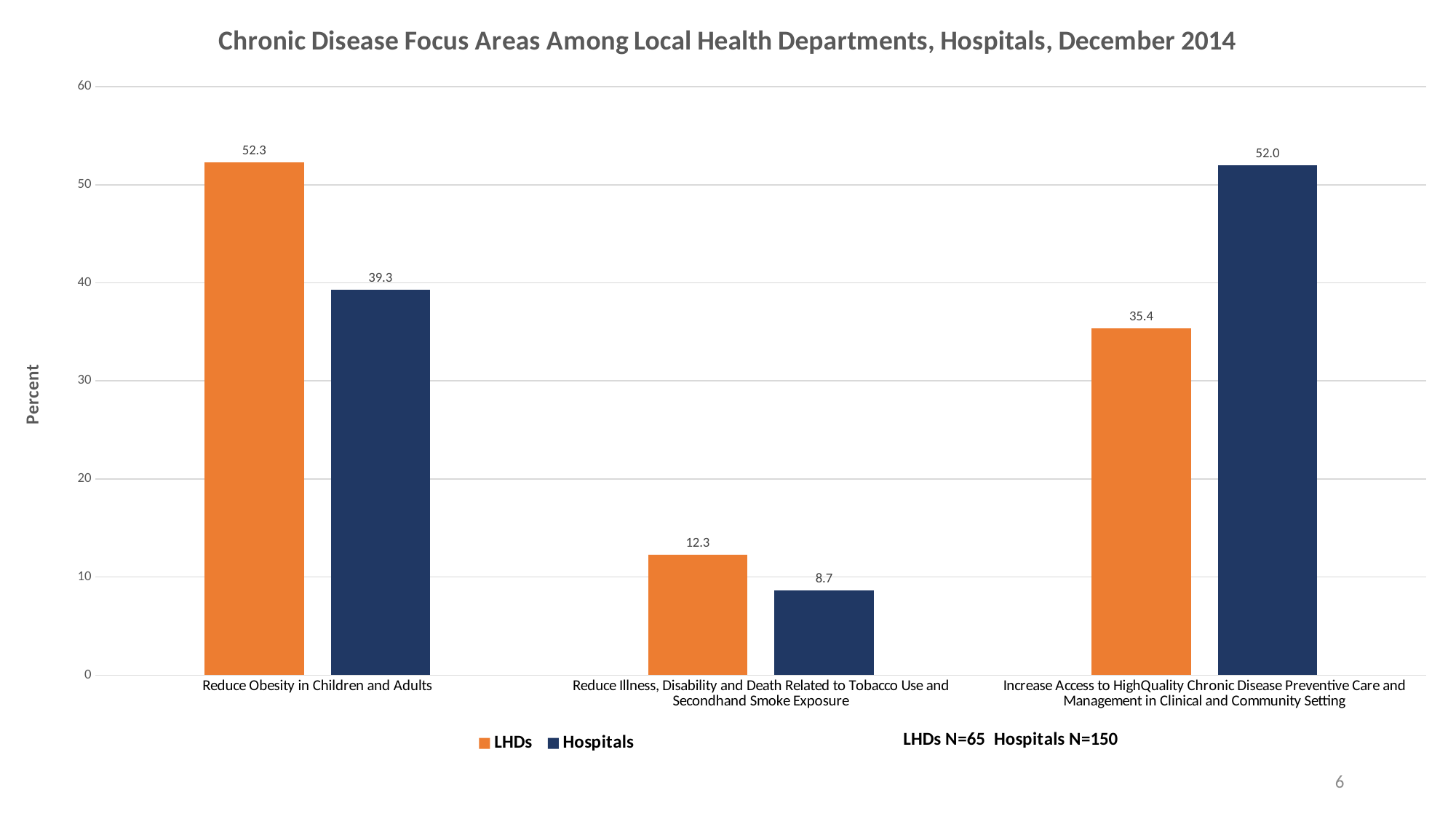
Which focus area has the lowest LHDs value? Reduce Illness, Disability and Death Related to Tobacco Use and Secondhand Smoke Exposure What kind of chart is shown on the slide? Bar chart What is the LHDs value for Reduce Obesity in Children and Adults? 52.3 Is the Hospitals value for Reduce Obesity in Children and Adults greater or less than 40? less For Increase Access to HighQuality Chronic Disease Preventive Care and Management in Clinical and Community Setting, which is larger: the LHDs value or the Hospitals value? Hospitals How many focus area categories are shown on the x axis? 3 What is the Hospitals value for Reduce Illness, Disability and Death Related to Tobacco Use and Secondhand Smoke Exposure? 8.7 What is the difference between the LHDs and Hospitals values for Reduce Obesity in Children and Adults? 13.0 What is the label of the y axis? Percent What is the Hospitals value for Increase Access to HighQuality Chronic Disease Preventive Care and Management in Clinical and Community Setting? 52.0 How many series does the legend list? 2 Which focus area has the highest Hospitals value? Increase Access to HighQuality Chronic Disease Preventive Care and Management in Clinical and Community Setting